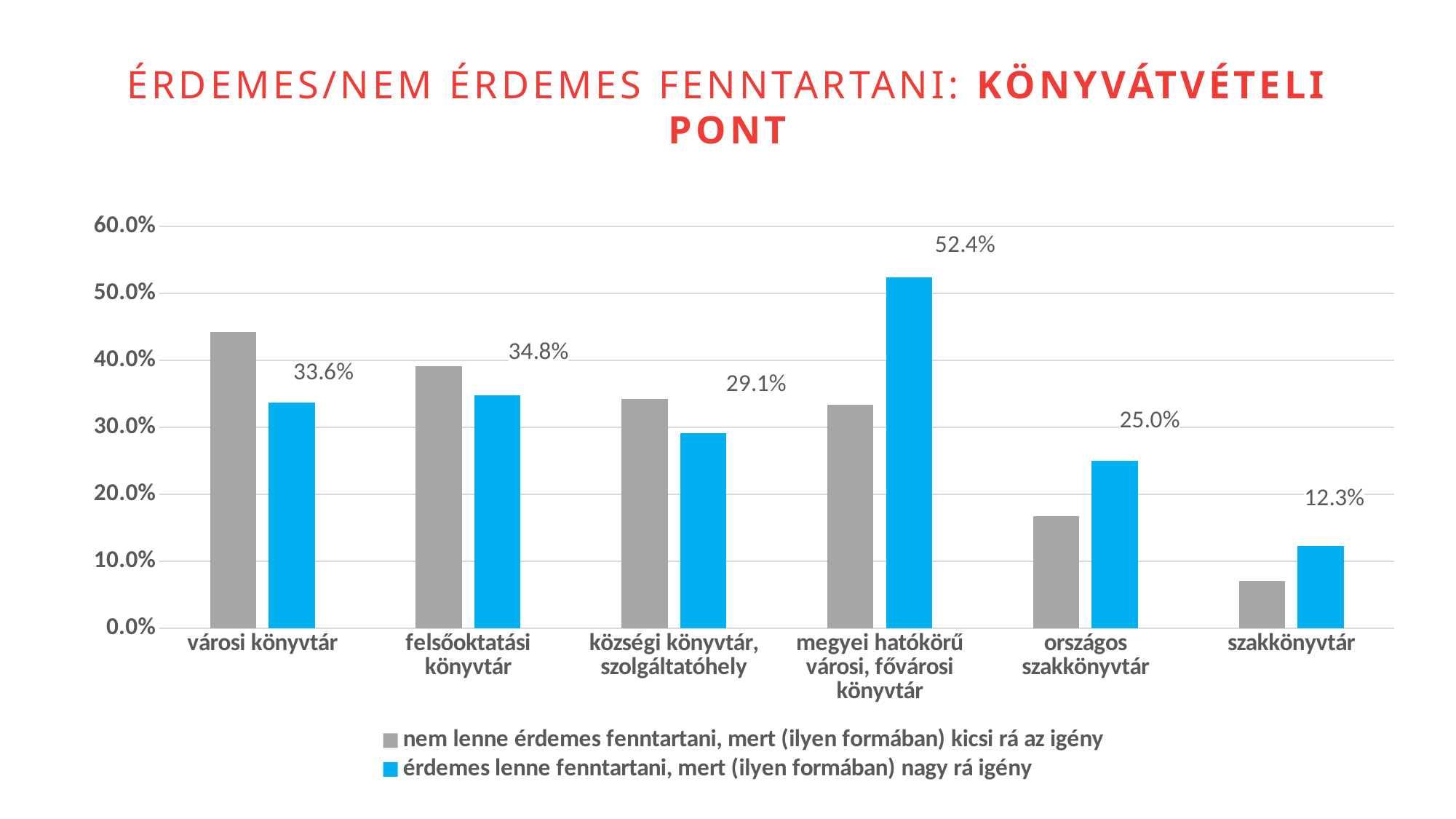
What is the value of the 'érdemes lenne fenntartani' series for 'megyei hatókörű városi, fővárosi könyvtár'? 52.4% What is the value of the 'érdemes lenne fenntartani' series for 'szakkönyvtár'? 12.3% What kind of chart is shown on the slide? bar chart What is the difference between the 'érdemes lenne fenntartani' values for 'megyei hatókörű városi, fővárosi könyvtár' and 'országos szakkönyvtár'? 27.4% Which category has the highest value in the 'érdemes lenne fenntartani' series? megyei hatókörű városi, fővárosi könyvtár How many categories are shown on the x axis? 6 Is the 'nem lenne érdemes fenntartani' value for 'városi könyvtár' greater or less than 40.0%? greater Which category has the lowest value in the 'érdemes lenne fenntartani' series? szakkönyvtár Is the 'nem lenne érdemes fenntartani' value for 'szakkönyvtár' greater or less than 10.0%? less What is the value of the 'érdemes lenne fenntartani' series for 'felsőoktatási könyvtár'? 34.8% For 'városi könyvtár', which series has the larger value: 'nem lenne érdemes fenntartani' or 'érdemes lenne fenntartani'? nem lenne érdemes fenntartani How many series does the legend list? 2